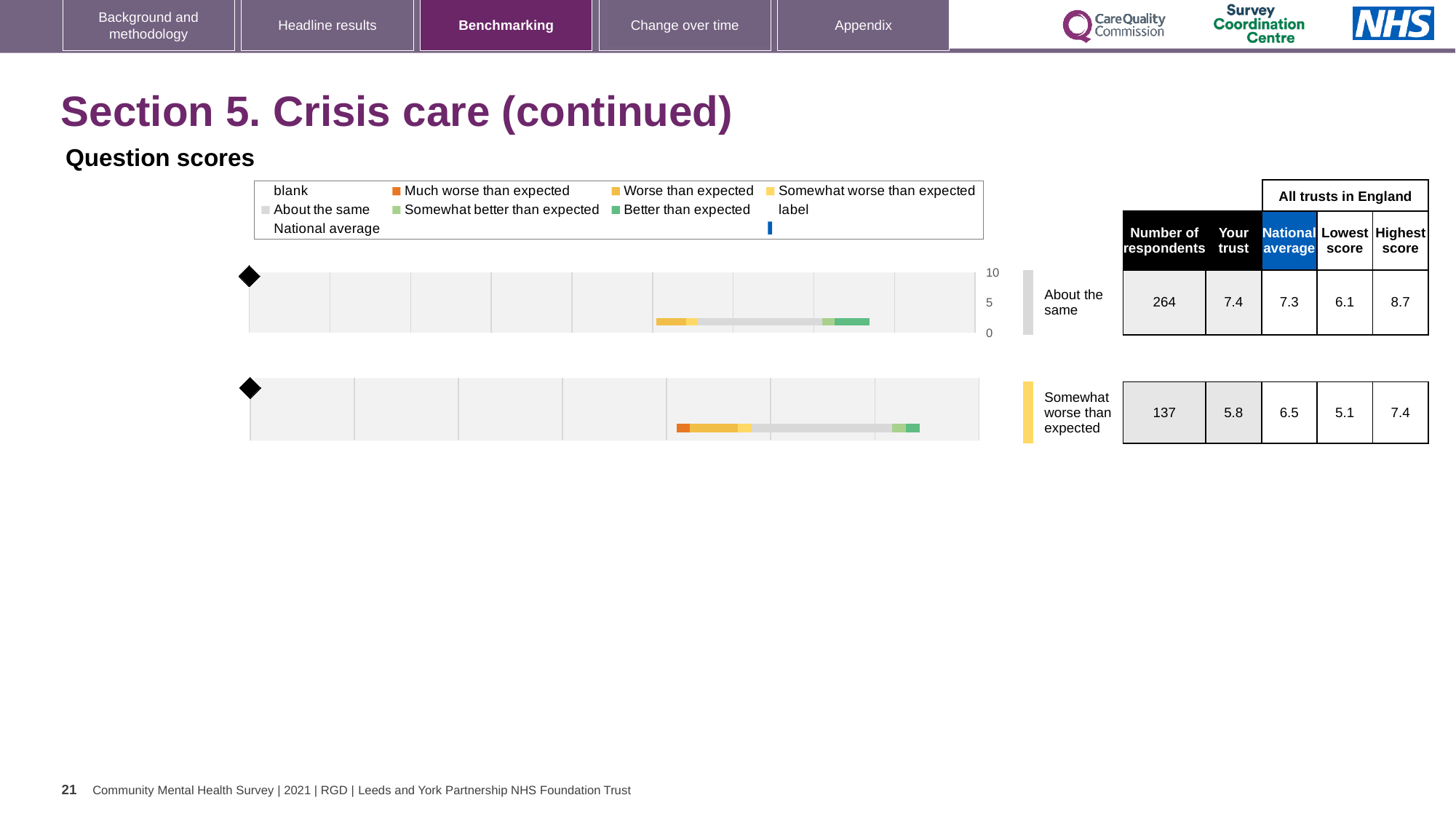
What is the lowest score among all trusts in England for the question rated 'About the same'? 6.1 How many respondents answered the question rated 'About the same'? 264 What is the national average for the question rated 'Somewhat worse than expected'? 6.5 What is the highest score among all trusts in England for the question rated 'Somewhat worse than expected'? 7.4 What kind of chart is used to show the question scores on this slide? bar chart For the question rated 'Somewhat worse than expected', which is larger: the trust's score or the national average? National average Which colour in the legend represents 'Much worse than expected'? Orange What is the maximum value shown on the score axis of the top chart? 10 What is the 'Your trust' score for the question rated 'About the same'? 7.4 How many question rows are plotted on the slide? 2 What is the difference between the highest and lowest scores for the question rated 'About the same'? 2.6 Which of the two questions has the higher 'Your trust' score? About the same